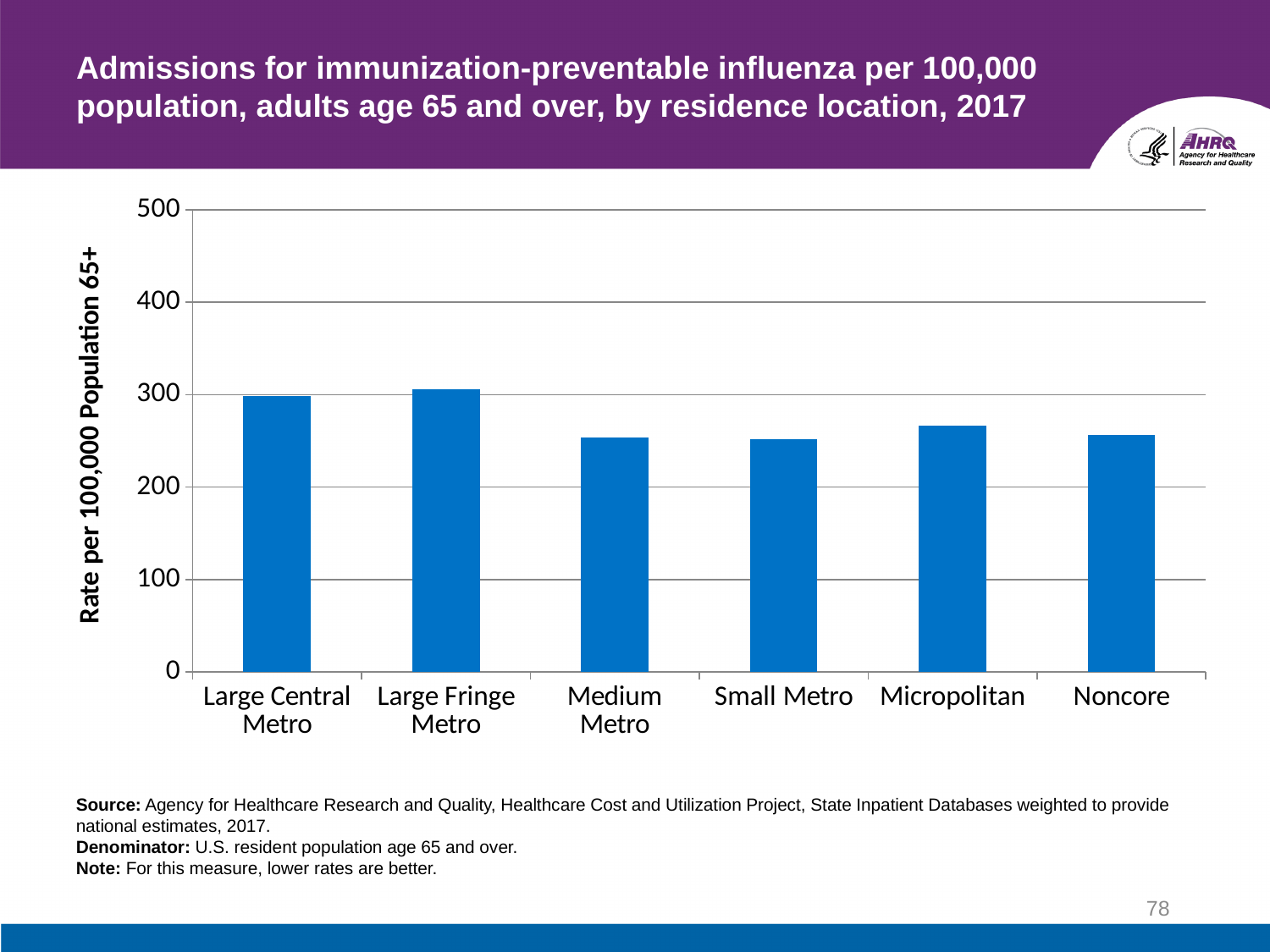
Which is larger, the value for Micropolitan or the value for Small Metro? Micropolitan Which residence location has the highest admission rate? Large Fringe Metro Which is larger, the value for Large Fringe Metro or the value for Medium Metro? Large Fringe Metro Is the value for Micropolitan greater or less than 200? greater Is the value for Medium Metro greater or less than 300? less Is the value for Small Metro greater or less than 200? greater What kind of chart is shown on the slide? bar chart What year of data does the chart title say is shown? 2017 What is the label on the y axis of the chart? Rate per 100,000 Population 65+ How many residence location categories are shown on the x axis? 6